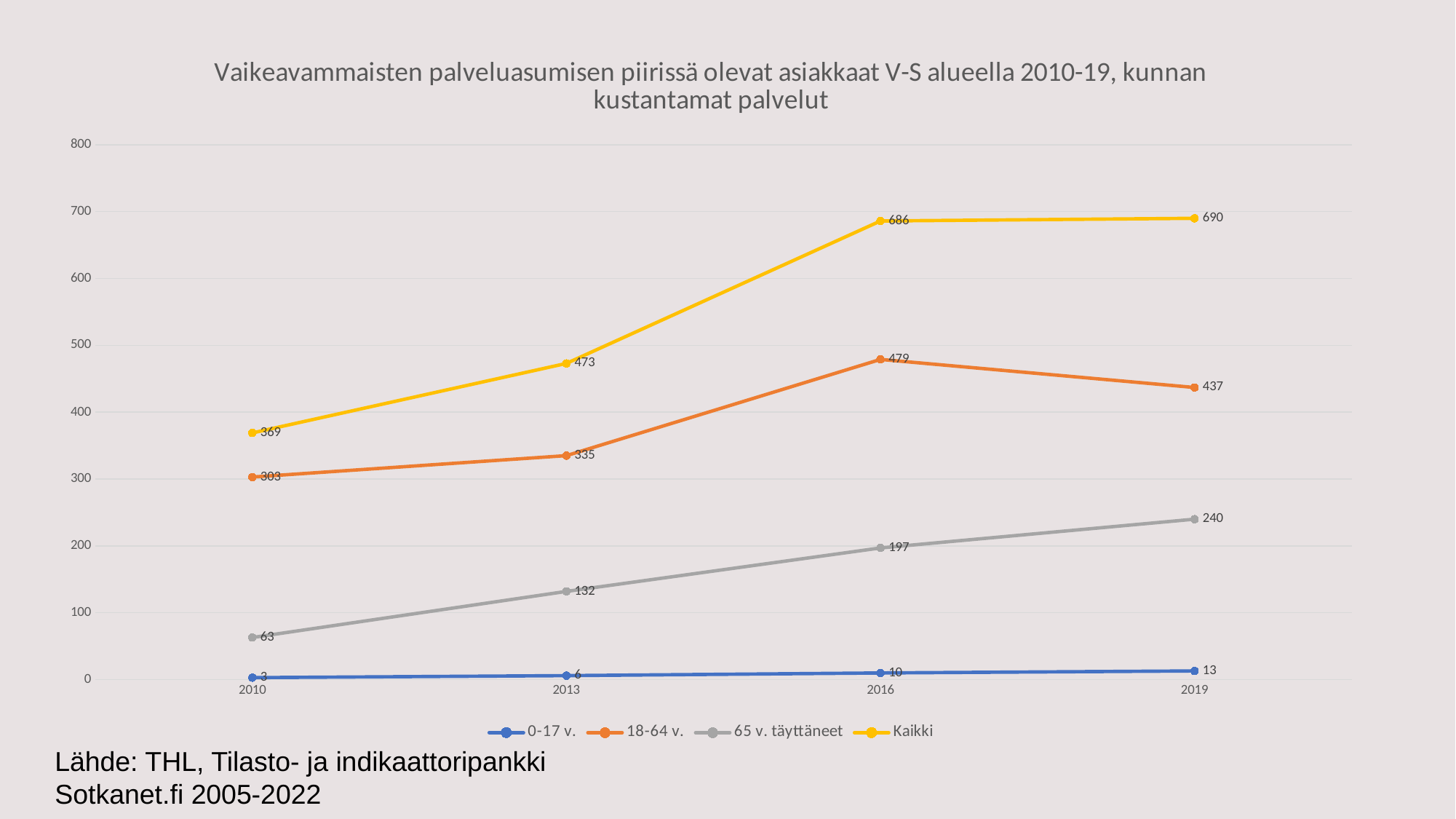
Does the value for 65 v. täyttäneet rise or fall from 2010 to 2019? rise How many series does the legend list? 4 What is the difference between the Kaikki values in 2019 and 2010? 321 In which year is the value for Kaikki lowest? 2010 What is the value for Kaikki in 2016? 686 What is the value for 65 v. täyttäneet in 2019? 240 What type of chart is shown on the slide? line chart What is the value for 0-17 v. in 2010? 3 How many years are plotted on the x axis? 4 Which is larger in 2019: the value for 18-64 v. or the value for 65 v. täyttäneet? 18-64 v. What is the value for 18-64 v. in 2013? 335 In which year is the value for 18-64 v. highest? 2016